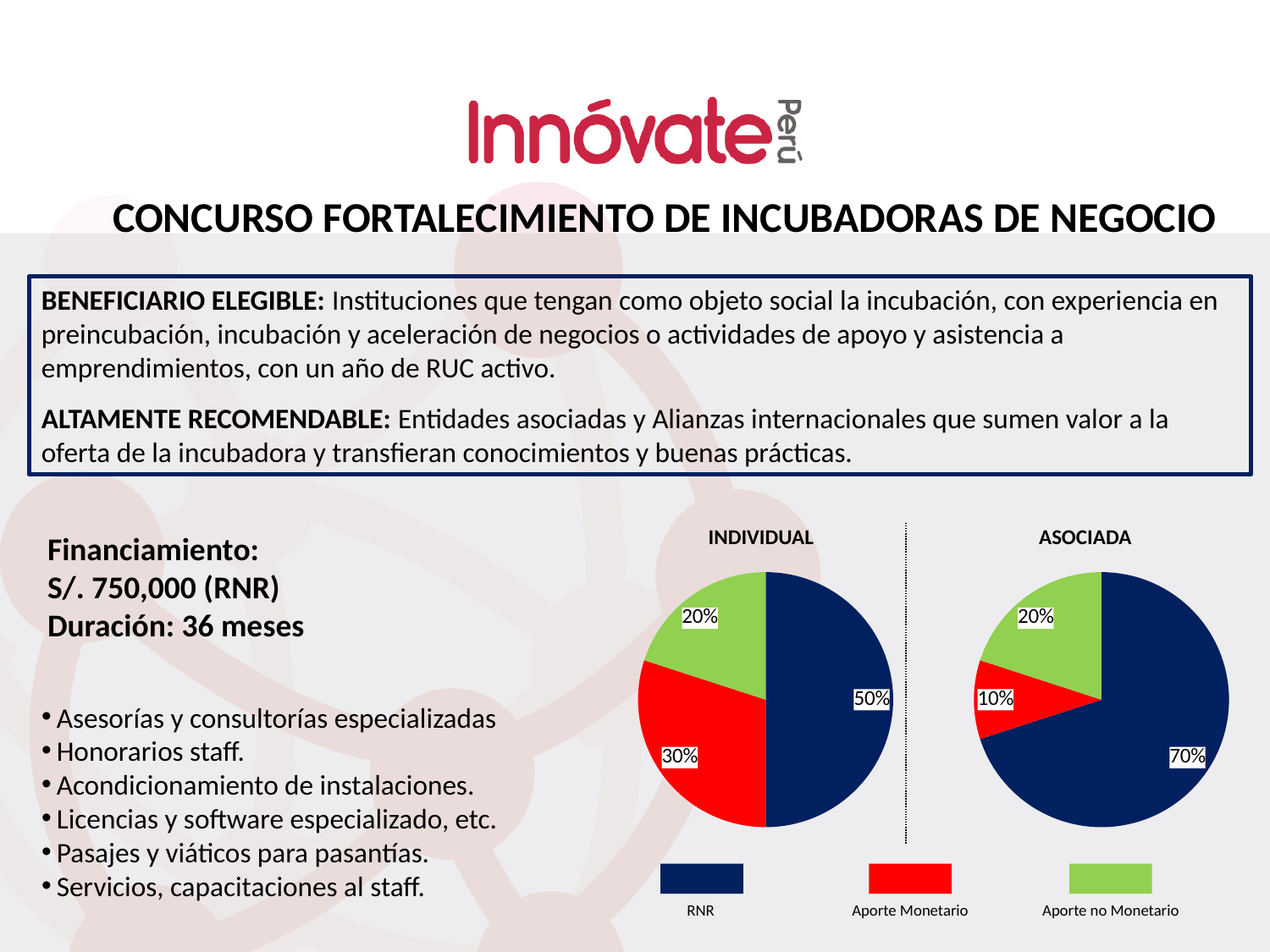
In the ASOCIADA pie chart, what share does RNR have? 70% What is the difference between the RNR share in the ASOCIADA chart and the RNR share in the INDIVIDUAL chart? 20% How many slices does the INDIVIDUAL pie chart have? 3 In the ASOCIADA pie chart, what share does Aporte no Monetario have? 20% In the ASOCIADA pie chart, which category has the smallest slice? Aporte Monetario In the ASOCIADA pie chart, what share does Aporte Monetario have? 10% In the INDIVIDUAL pie chart, which category has the largest slice? RNR In the INDIVIDUAL pie chart, what share does Aporte Monetario have? 30% Is the Aporte Monetario share larger in the INDIVIDUAL chart or the ASOCIADA chart? INDIVIDUAL In the INDIVIDUAL pie chart, what share does RNR have? 50% What type of chart is used for INDIVIDUAL and ASOCIADA? Pie chart Which colour represents Aporte no Monetario in the legend? Green